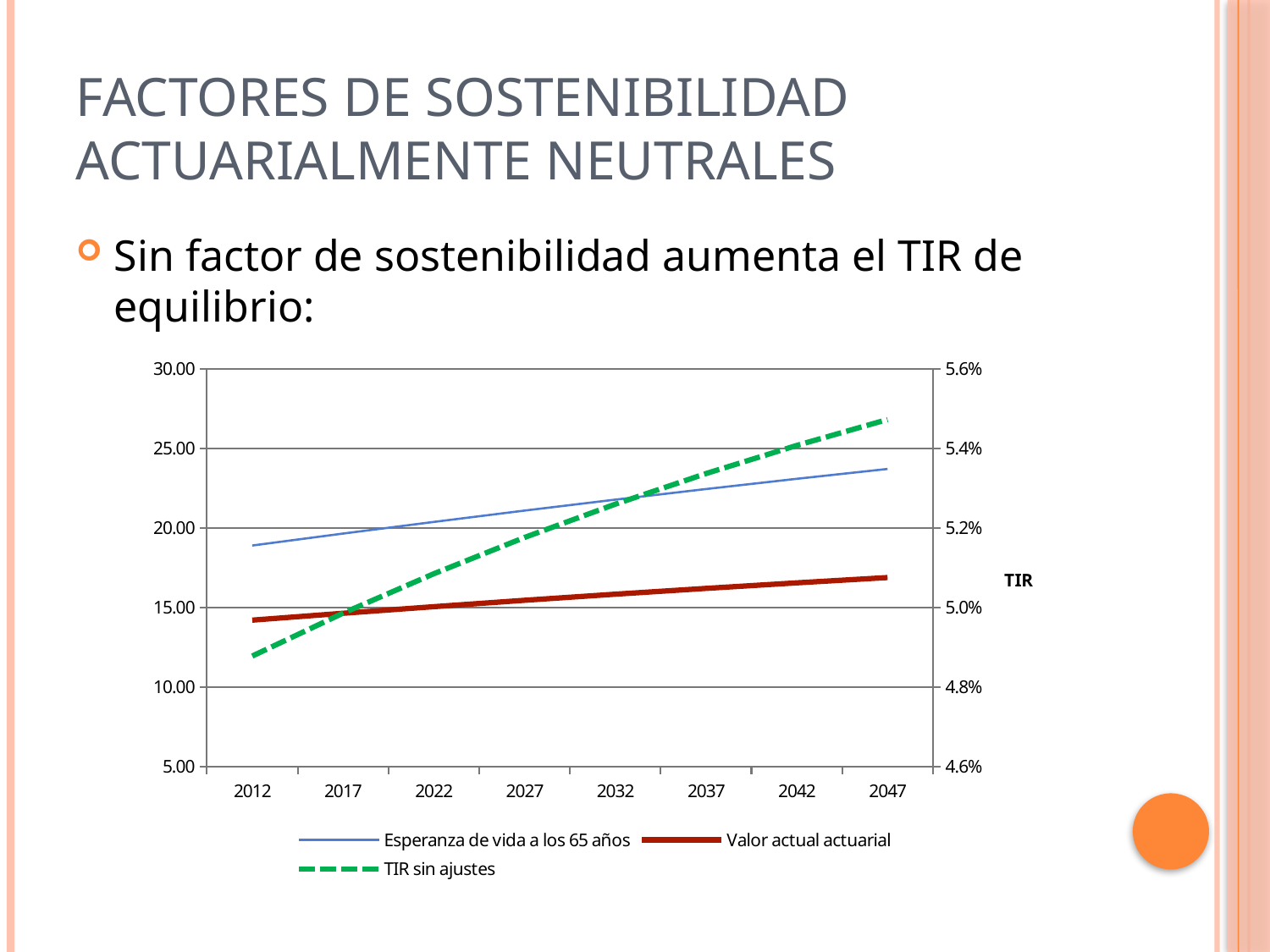
How many years are labelled on the x axis? 8 What kind of chart is shown on the slide? line chart What label is shown next to the right-hand vertical axis of the chart? TIR Does the 'Esperanza de vida a los 65 años' line rise or fall from 2012 to 2047? rise Does the 'Valor actual actuarial' line rise or fall from 2012 to 2047? rise Is the value for 'Valor actual actuarial' in 2012 greater or less than 15.00 on the left axis? less Is the value for 'Esperanza de vida a los 65 años' in 2047 greater or less than 20.00 on the left axis? greater Is the value for 'TIR sin ajustes' in 2047 greater or less than 5.4% on the right axis? greater How many series does the legend list? 3 Does the 'TIR sin ajustes' line rise or fall from 2012 to 2047? rise